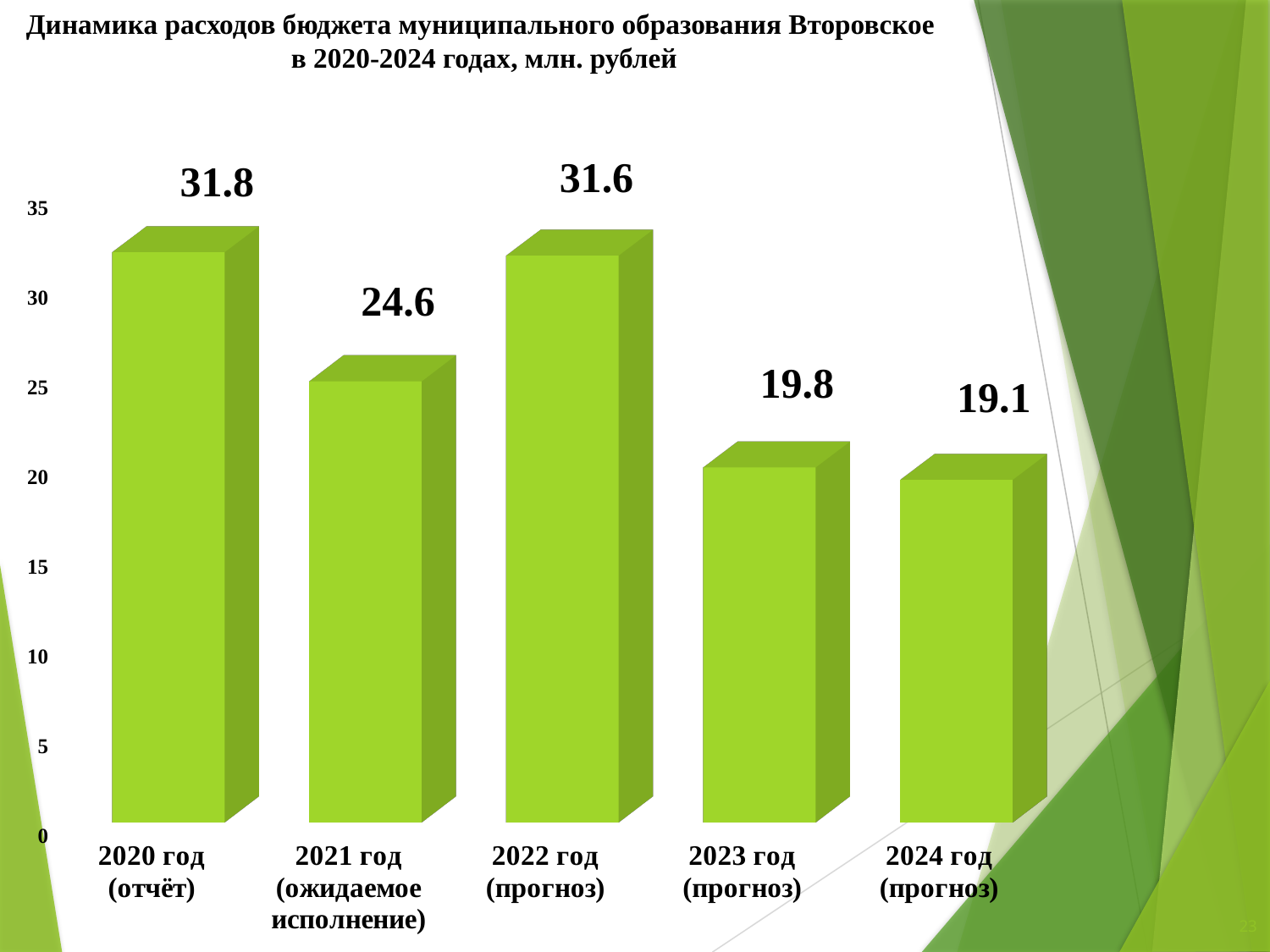
Which year has the lowest value? 2024 год (прогноз) What is the value for 2024 год (прогноз)? 19.1 What is the difference between the values for 2022 год and 2023 год? 11.8 What unit is stated in the chart title? млн. рублей What is the value for 2021 год (ожидаемое исполнение)? 24.6 What is the value for 2020 год (отчёт)? 31.8 Which year has the highest value? 2020 год (отчёт) What kind of chart is shown on the slide? bar chart Is the value for 2022 год (прогноз) greater or less than 30? greater What is the difference between the values for 2020 год and 2021 год? 7.2 How many years are shown on the chart? 5 Which is larger, the value for 2021 год or the value for 2023 год? 2021 год